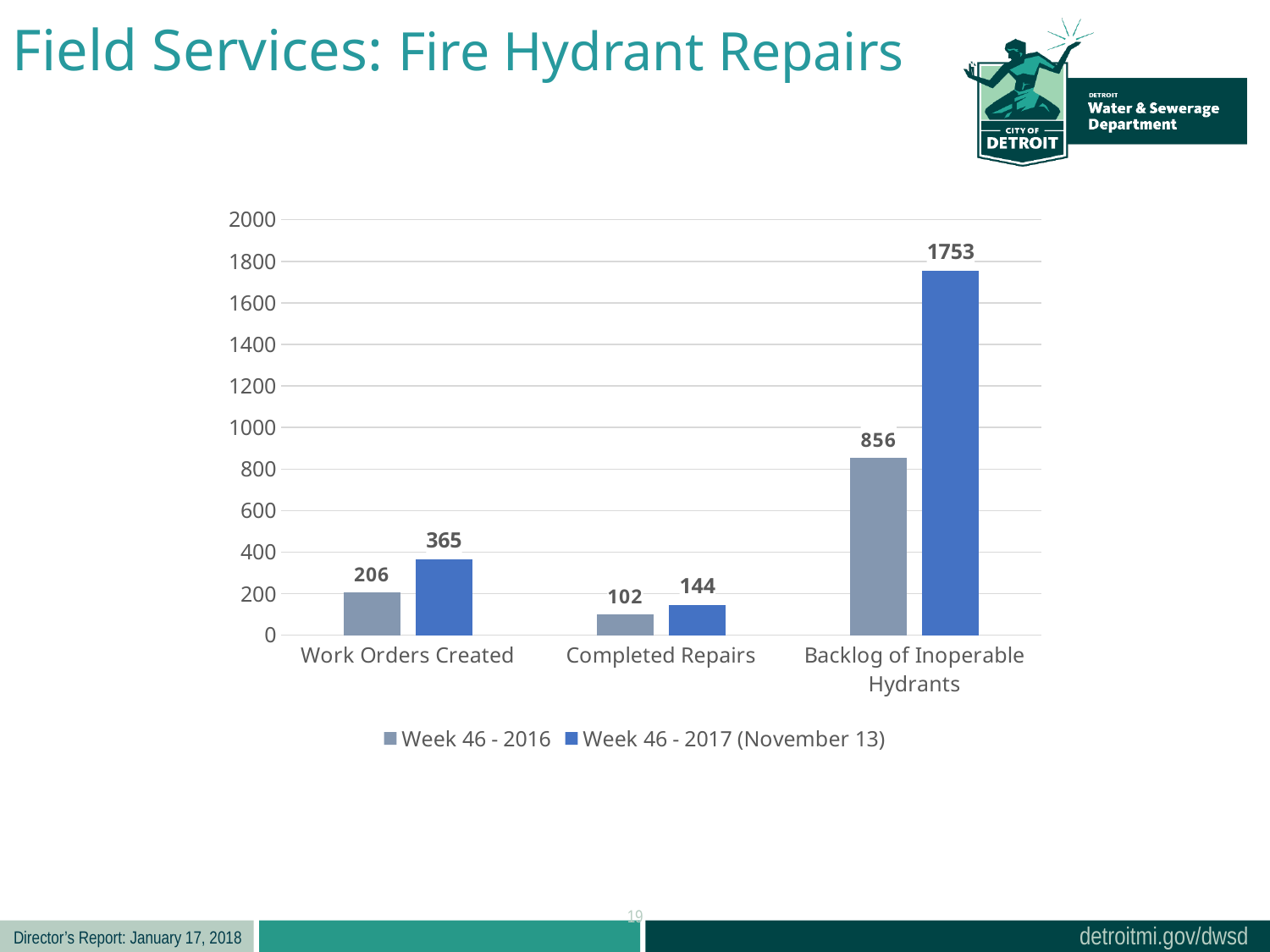
How many categories are shown on the x axis? 3 Which category has the lowest value for Week 46 - 2017 (November 13)? Completed Repairs What is the value for Work Orders Created in Week 46 - 2016? 206 What is the difference between the Week 46 - 2017 and Week 46 - 2016 values for Work Orders Created? 159 How many series does the legend list? 2 What kind of chart is shown on the slide? bar chart What is the value for Completed Repairs in Week 46 - 2017 (November 13)? 144 Is the value for Backlog of Inoperable Hydrants in Week 46 - 2016 greater or less than 1000? less What is the value for Backlog of Inoperable Hydrants in Week 46 - 2017 (November 13)? 1753 Which is larger for Completed Repairs: Week 46 - 2016 or Week 46 - 2017 (November 13)? Week 46 - 2017 (November 13) Which category has the highest value for Week 46 - 2016? Backlog of Inoperable Hydrants What is the difference between the Week 46 - 2017 and Week 46 - 2016 values for Backlog of Inoperable Hydrants? 897